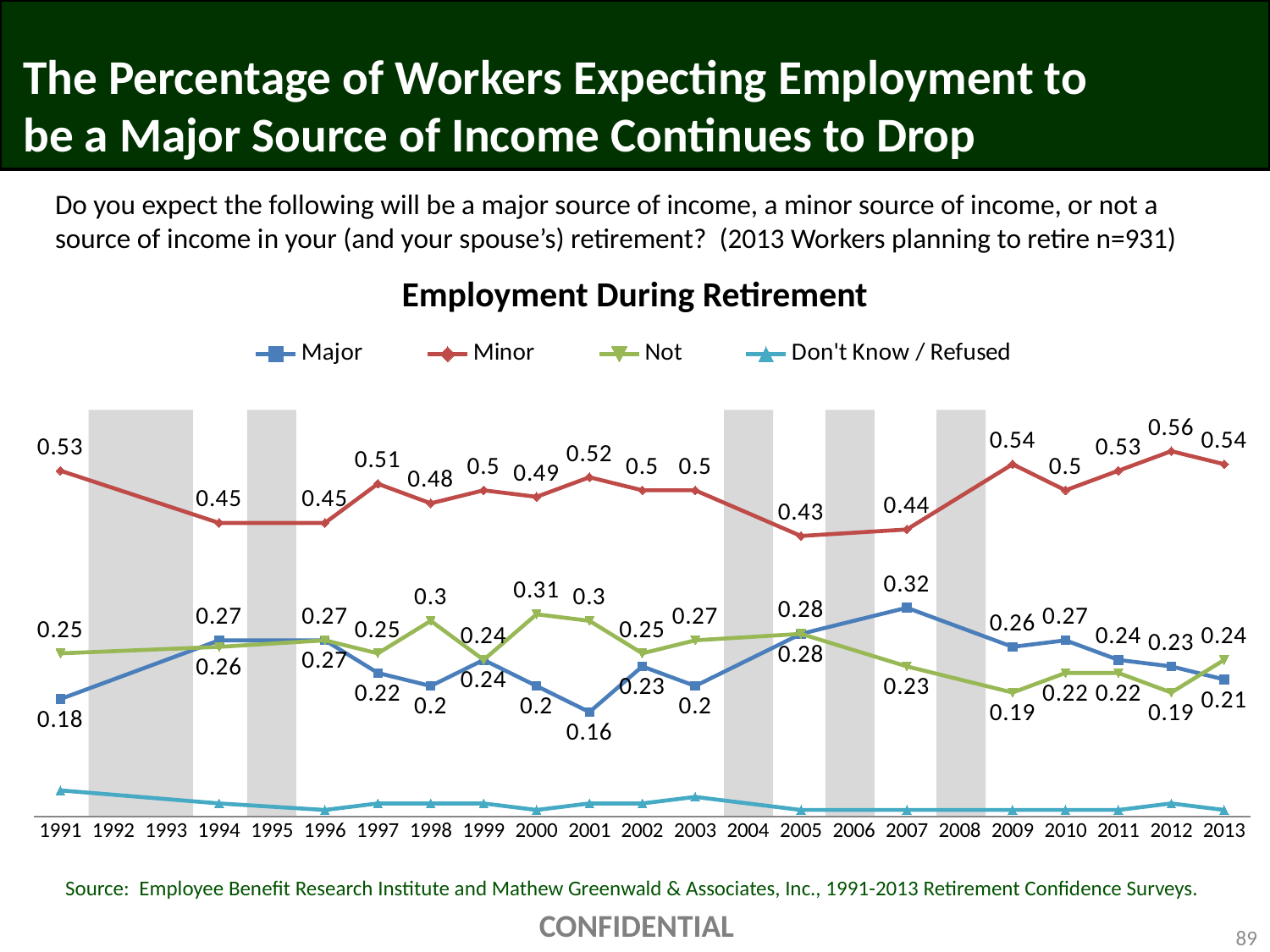
In which year does the Major series reach its lowest value? 2001 What is the difference between the Minor value in 2012 and the Minor value in 2005? 0.13 In which year does the Minor series reach its highest value? 2012 What is the value of the Minor series in 2013? 0.54 By how much did the Major series fall from 2007 to 2013? 0.11 What is the value of the Major series in 1991? 0.18 What is the value of the Major series in 2007? 0.32 What is the value of the Not series in 2000? 0.31 In 2013, which is larger: the Major value or the Not value? Not How many series does the legend of the "Employment During Retirement" chart list? 4 What kind of chart is shown under the title "Employment During Retirement"? line chart Does the Major series rise or fall from 2007 to 2013? fall